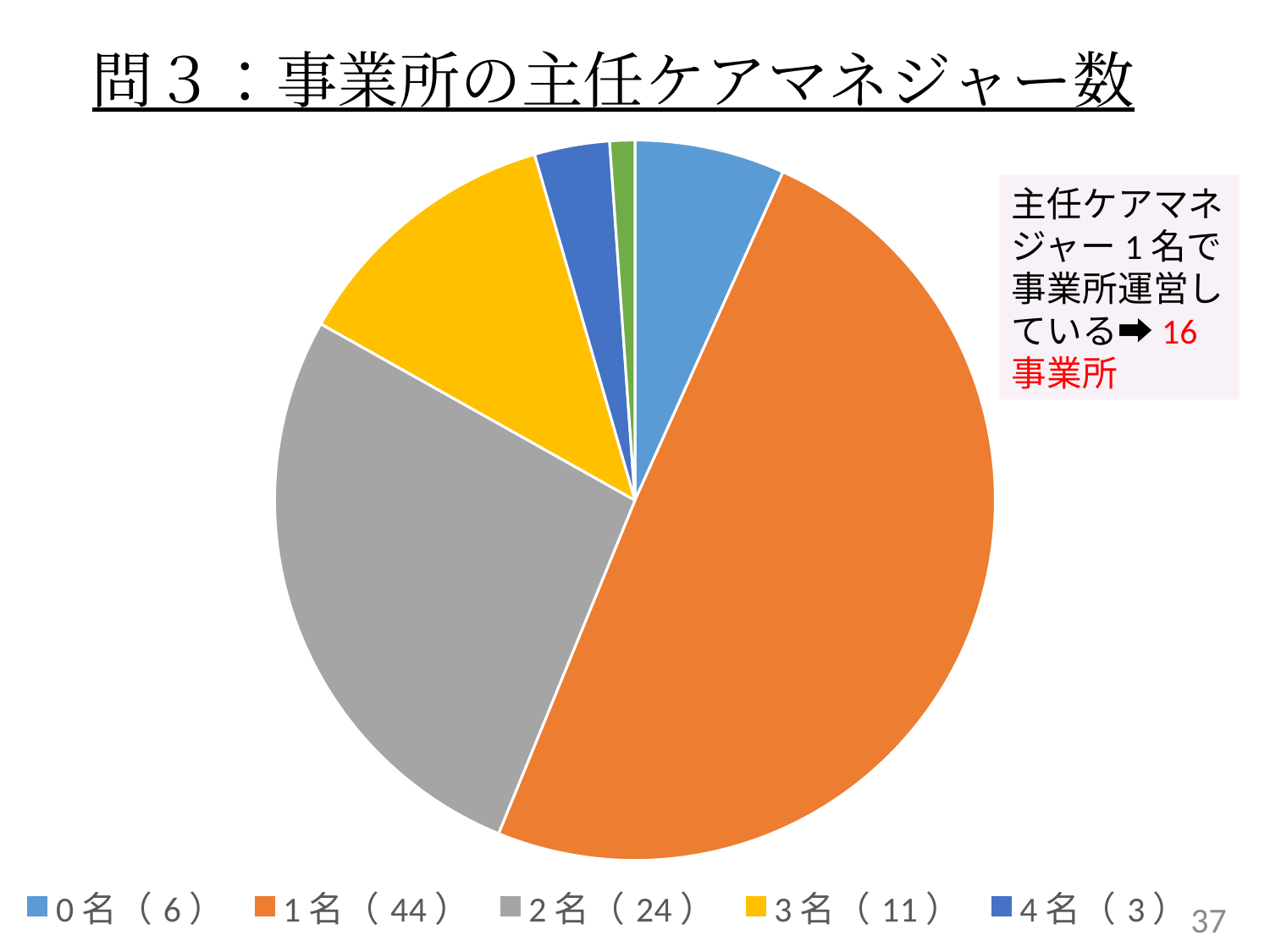
What is the count shown in the legend for 2名? 24 What is the count shown in the legend for 3名? 11 What is the count shown in the legend for 4名? 3 What colour is the slice for 2名? gray What is the title of the chart? 問３：事業所の主任ケアマネジャー数 What is the count shown in the legend for 1名? 44 Which category has the largest slice of the pie? 1名 What kind of chart is shown on the slide? pie chart What is the count shown in the legend for 0名? 6 Which is larger, the count for 3名 or the count for 0名? 3名 How many entries does the legend list? 5 What is the difference between the counts for 1名 and 2名? 20